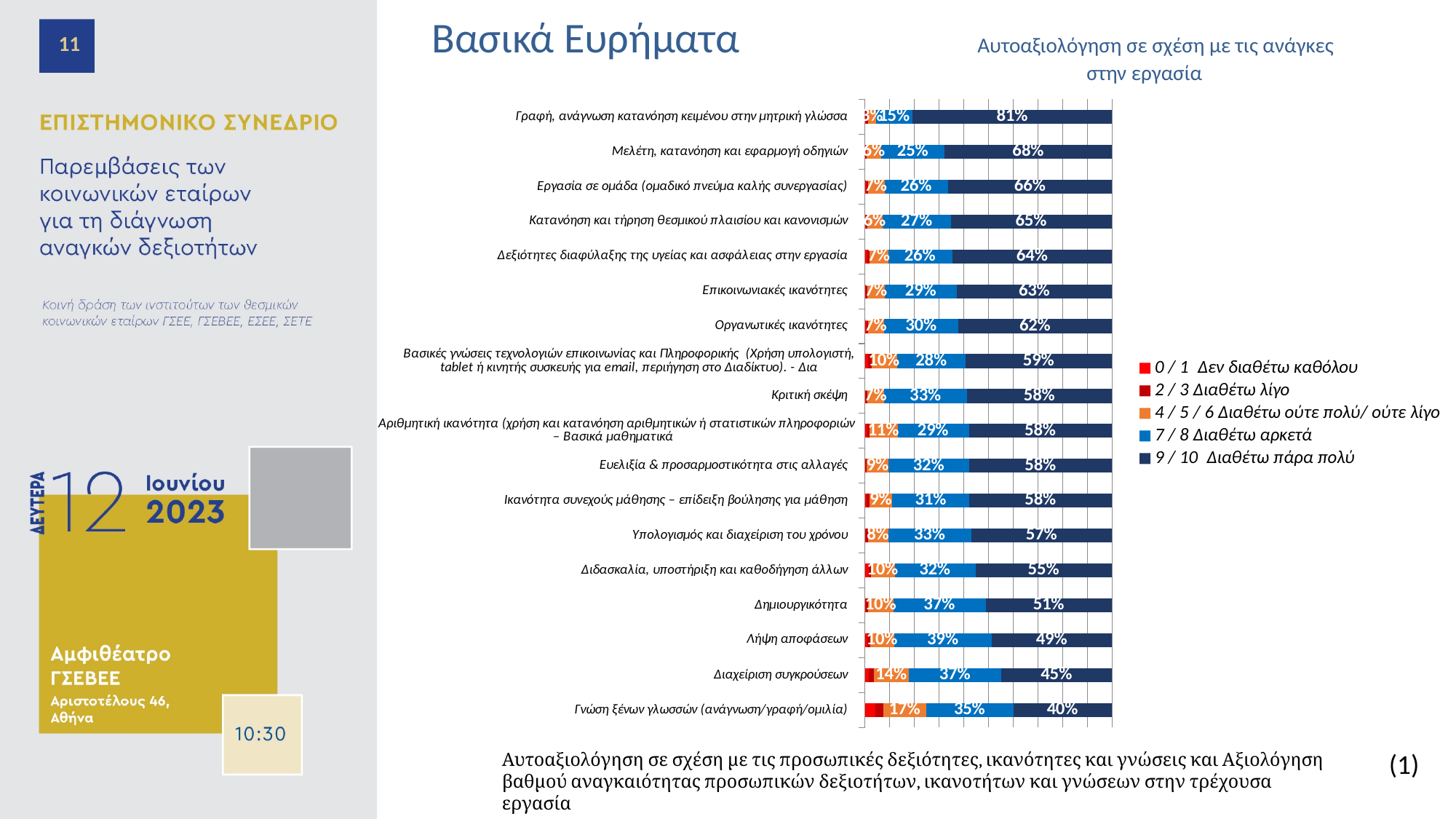
What is the value of the '7 / 8 Διαθέτω αρκετά' series for 'Λήψη αποφάσεων'? 39% What is the value of the '9 / 10 Διαθέτω πάρα πολύ' series for 'Διαχείριση συγκρούσεων'? 45% How many series does the legend list? 5 What is the value of the '9 / 10 Διαθέτω πάρα πολύ' series for 'Γραφή, ανάγνωση κατανόηση κειμένου στην μητρική γλώσσα'? 81% Which category has the lowest value for the '9 / 10 Διαθέτω πάρα πολύ' series? Γνώση ξένων γλωσσών (ανάγνωση/γραφή/ομιλία) What is the difference between the '9 / 10 Διαθέτω πάρα πολύ' values for 'Μελέτη, κατανόηση και εφαρμογή οδηγιών' and 'Δημιουργικότητα'? 17% What is the title shown above the chart? Αυτοαξιολόγηση σε σχέση με τις ανάγκες στην εργασία Which category has the highest value for the '9 / 10 Διαθέτω πάρα πολύ' series? Γραφή, ανάγνωση κατανόηση κειμένου στην μητρική γλώσσα Which is larger: the '7 / 8 Διαθέτω αρκετά' value for 'Κριτική σκέψη' or for 'Επικοινωνιακές ικανότητες'? Κριτική σκέψη What kind of chart is shown on the slide? Stacked horizontal bar chart What is the value of the '4 / 5 / 6 Διαθέτω ούτε πολύ/ ούτε λίγο' series for 'Γνώση ξένων γλωσσών (ανάγνωση/γραφή/ομιλία)'? 17% How many categories (skills) are plotted on the chart? 18